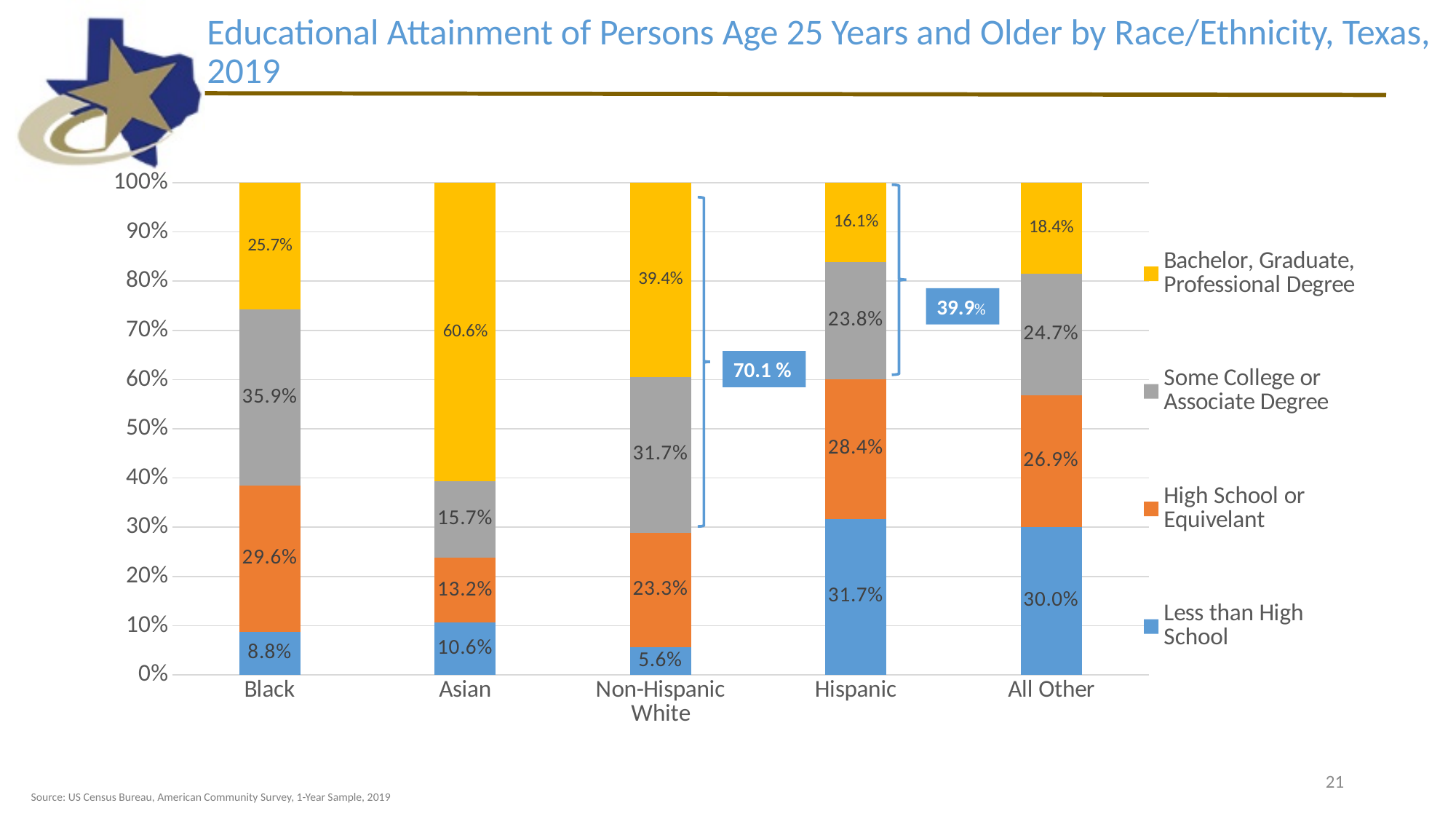
How many educational attainment series does the legend list? 4 What percentage of Asian persons age 25 and older have a Bachelor, Graduate, or Professional Degree? 60.6% What is the difference in percentage points between the Some College or Associate Degree share for Black (35.9%) and Asian (15.7%)? 20.2 percentage points How many percentage points higher is the Bachelor, Graduate, Professional Degree share for Asian than for Hispanic? 44.5 percentage points What is the High School or Equivalent share for the All Other group? 26.9% What is the Less than High School share for the Hispanic group? 31.7% What kind of chart is shown on the slide? Stacked bar chart What colour represents the Bachelor, Graduate, Professional Degree series in the legend? Yellow Which group has a larger Less than High School share, Hispanic or All Other? Hispanic How many race/ethnicity categories are shown on the x axis? 5 Which race/ethnicity group has the highest share with a Bachelor, Graduate, or Professional Degree? Asian Which race/ethnicity group has the lowest Less than High School share? Non-Hispanic White